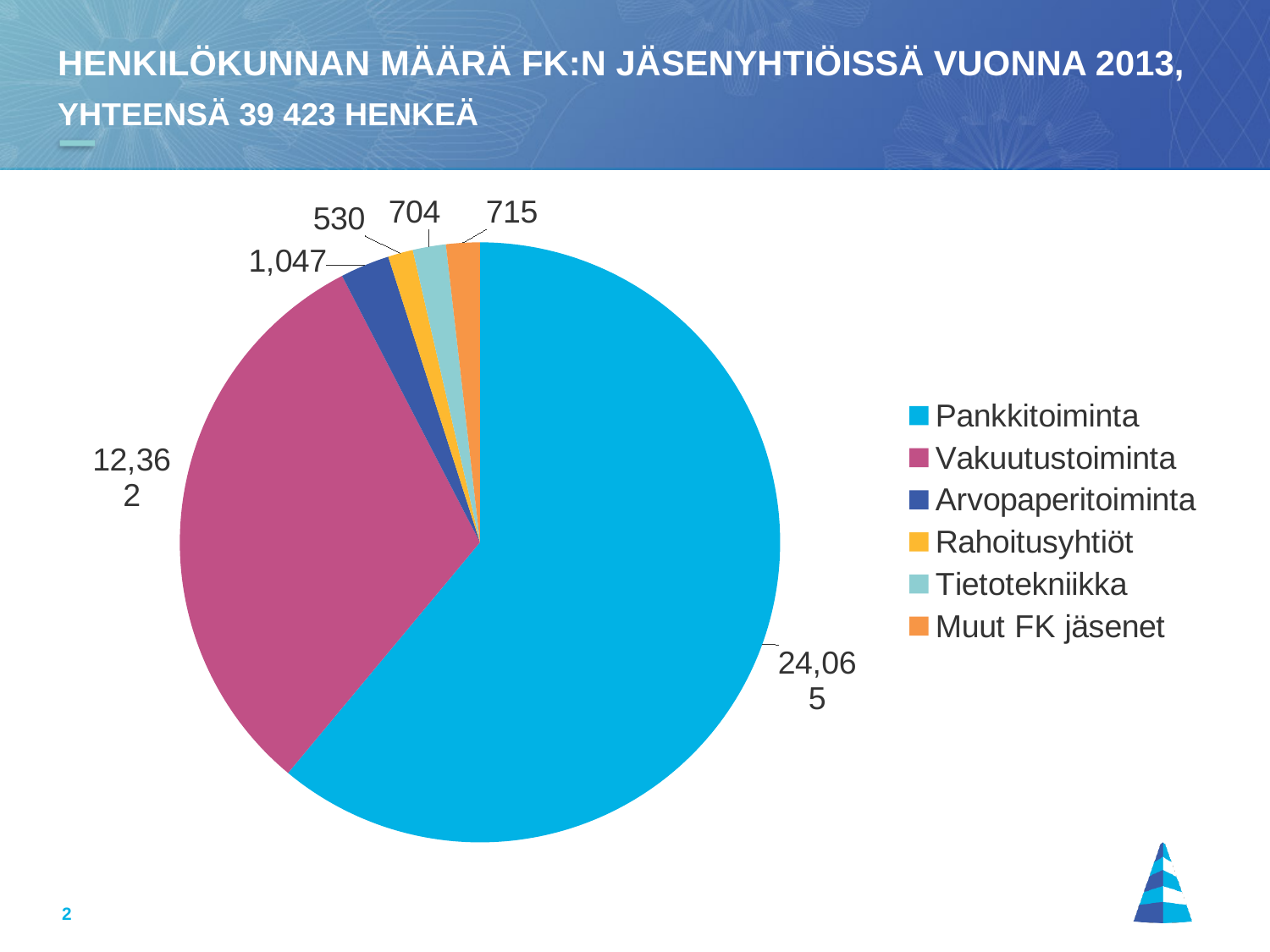
Which category has the largest slice? Pankkitoiminta How many entries does the legend list? 6 Which category has the smallest slice? Rahoitusyhtiöt How many slices does the pie chart have? 6 Which is larger, the value for Arvopaperitoiminta or the value for Tietotekniikka? Arvopaperitoiminta What is the value for Arvopaperitoiminta? 1,047 What is the value for Pankkitoiminta? 24,065 What total number of people does the slide title state for 2013? 39 423 What is the difference between the values for Pankkitoiminta and Vakuutustoiminta? 11,703 What is the value for Rahoitusyhtiöt? 530 What kind of chart is shown on the slide? pie chart What is the value for Vakuutustoiminta? 12,362